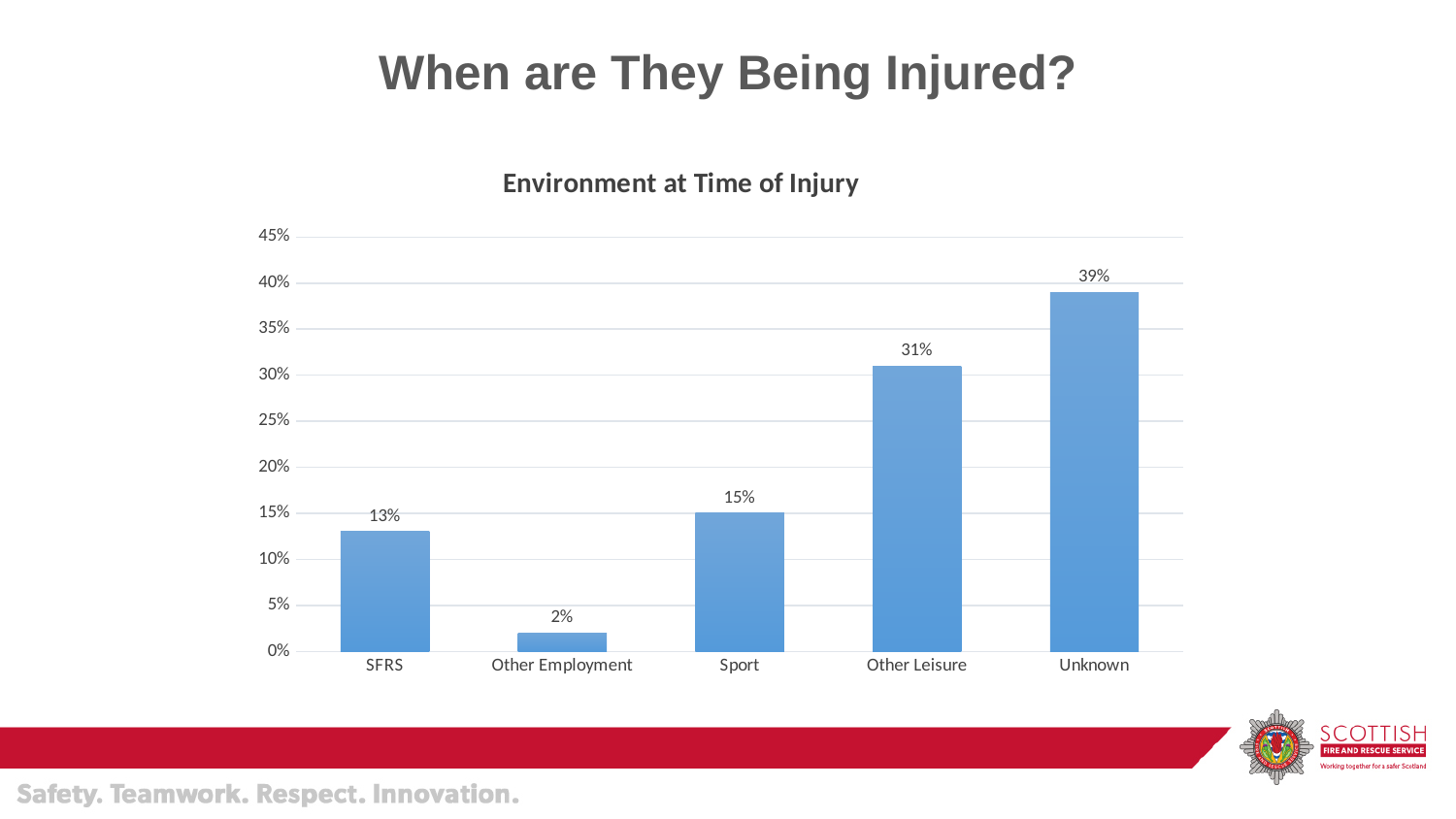
Which category has the highest value? Unknown How many categories are shown on the x axis? 5 What is the title of the chart? Environment at Time of Injury What kind of chart is shown on the slide? bar chart What is the difference between the values for Sport and SFRS? 2% What is the difference between the values for Unknown and Other Leisure? 8% Is the value for Other Leisure greater or less than 25%? greater Which is larger, the value for SFRS or the value for Other Leisure? Other Leisure What is the value for Other Employment? 2% Which category has the lowest value? Other Employment What is the value for Unknown in the Environment at Time of Injury chart? 39% What is the value for Sport? 15%